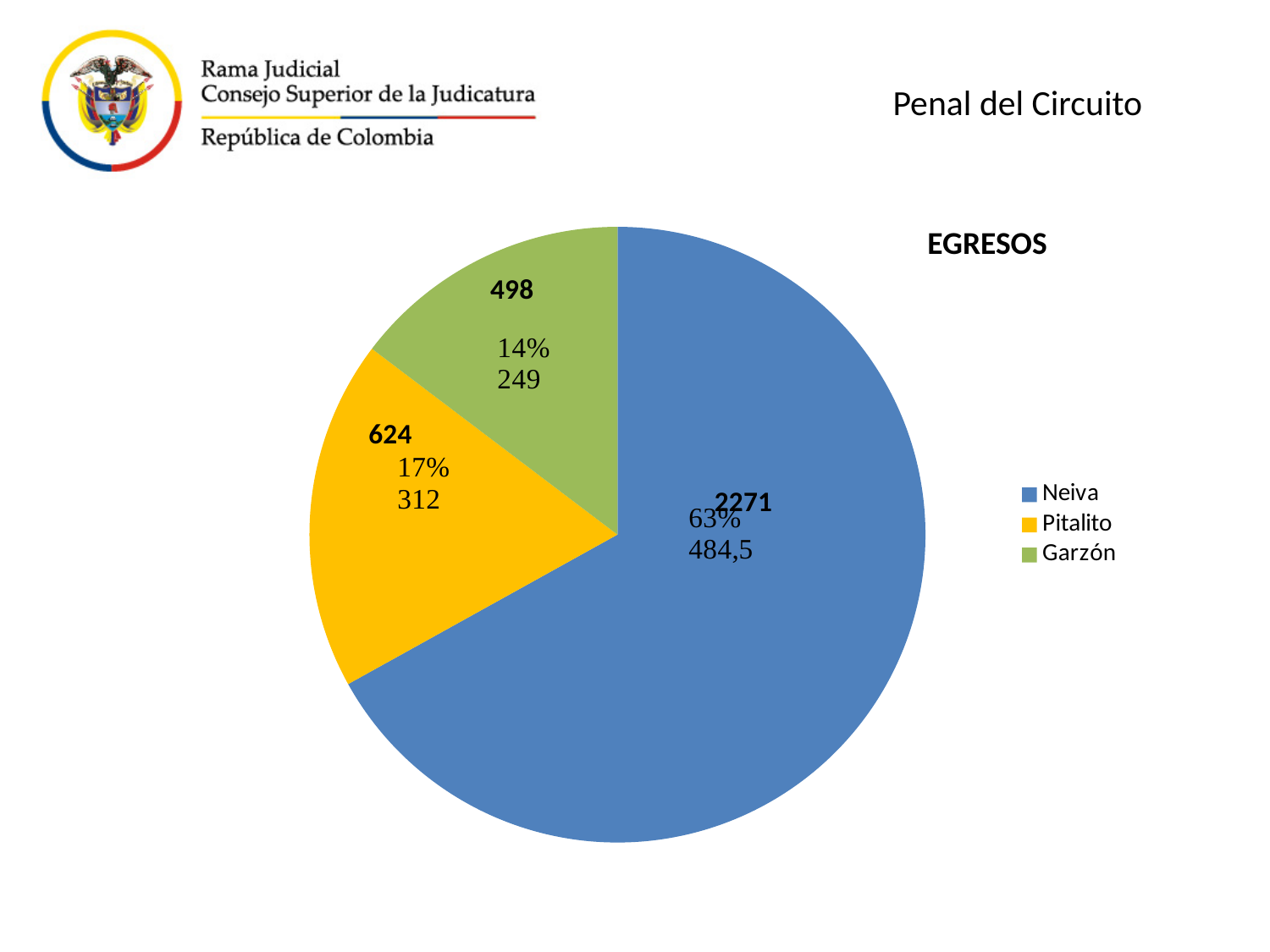
What type of chart is shown on the slide? pie chart Which is larger, the value for Pitalito or the value for Garzón? Pitalito What colour is the slice for Garzón? green What is the value shown for Neiva? 2271 What is the title of the chart? EGRESOS How many categories does the legend list? 3 What is the value shown for Pitalito? 624 Which category has the smallest slice? Garzón What is the value shown for Garzón? 498 What is the difference between the values for Neiva and Pitalito? 1647 Which category has the largest slice? Neiva What is the difference between the values for Pitalito and Garzón? 126